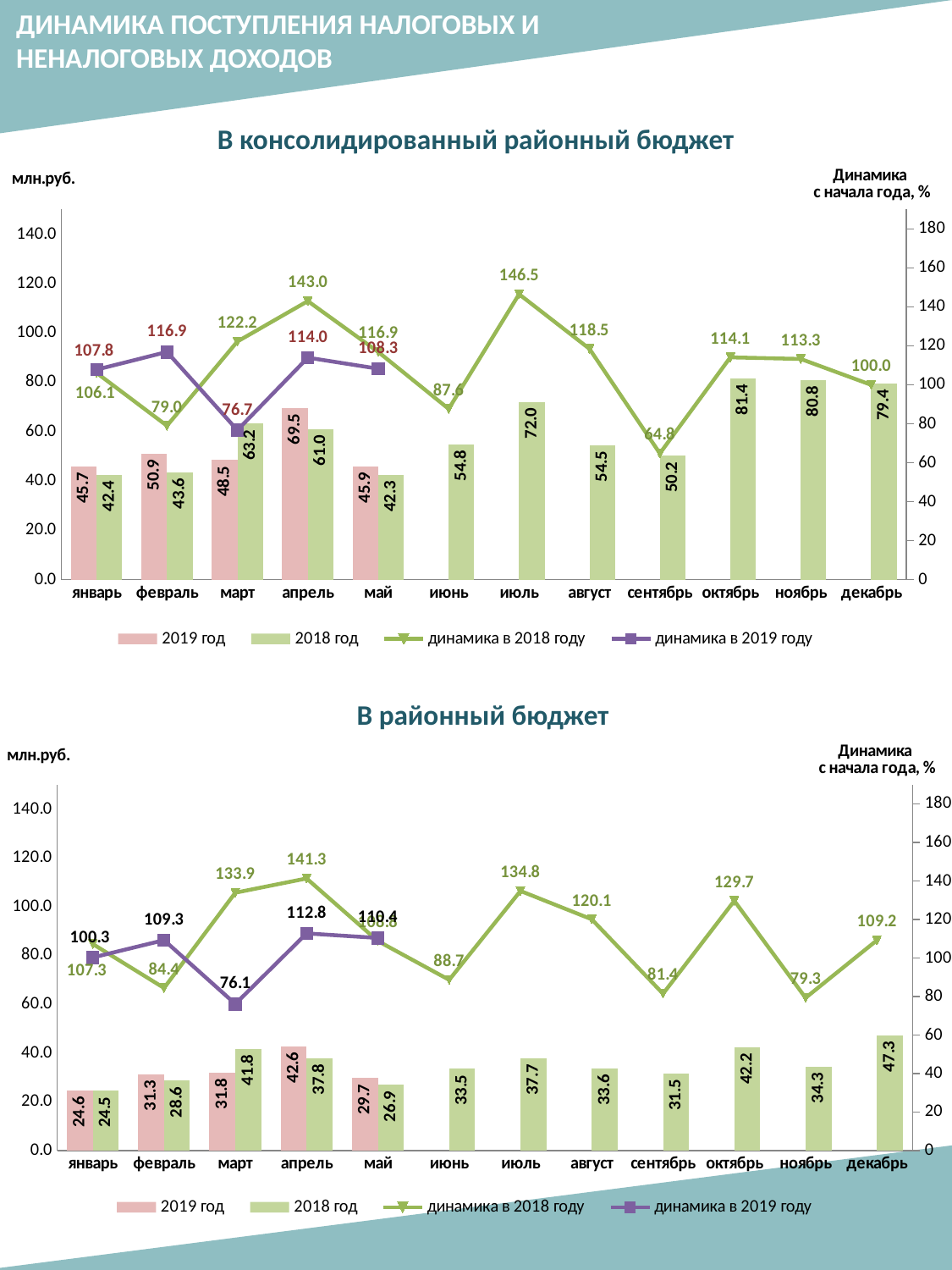
In the chart 'В районный бюджет', what is the value of 'динамика в 2019 году' for март? 76.1 In the chart 'В районный бюджет', what is the value of the 2018 год bar for декабрь? 47.3 In the chart 'В консолидированный районный бюджет', what is the value of the 2018 год bar for июль? 72.0 In the chart 'В консолидированный районный бюджет', what is the difference between the 2019 год and 2018 год bars for апрель? 8.5 In the chart 'В районный бюджет', in which month does the 'динамика в 2018 году' line reach its highest value? апрель In the chart 'В консолидированный районный бюджет', which month has the highest 2018 год bar? октябрь In the chart 'В районный бюджет', which is larger for февраль: the 2019 год bar or the 2018 год bar? 2019 год How many months are shown on the x axis of the chart 'В районный бюджет'? 12 In the chart 'В консолидированный районный бюджет', what is the value of the 2019 год bar for апрель? 69.5 How many series does the legend of the chart 'В консолидированный районный бюджет' list? 4 In the chart 'В консолидированный районный бюджет', in which month is the 'динамика в 2018 году' line at its lowest? сентябрь What kind of chart is 'В районный бюджет'? Combined bar and line chart